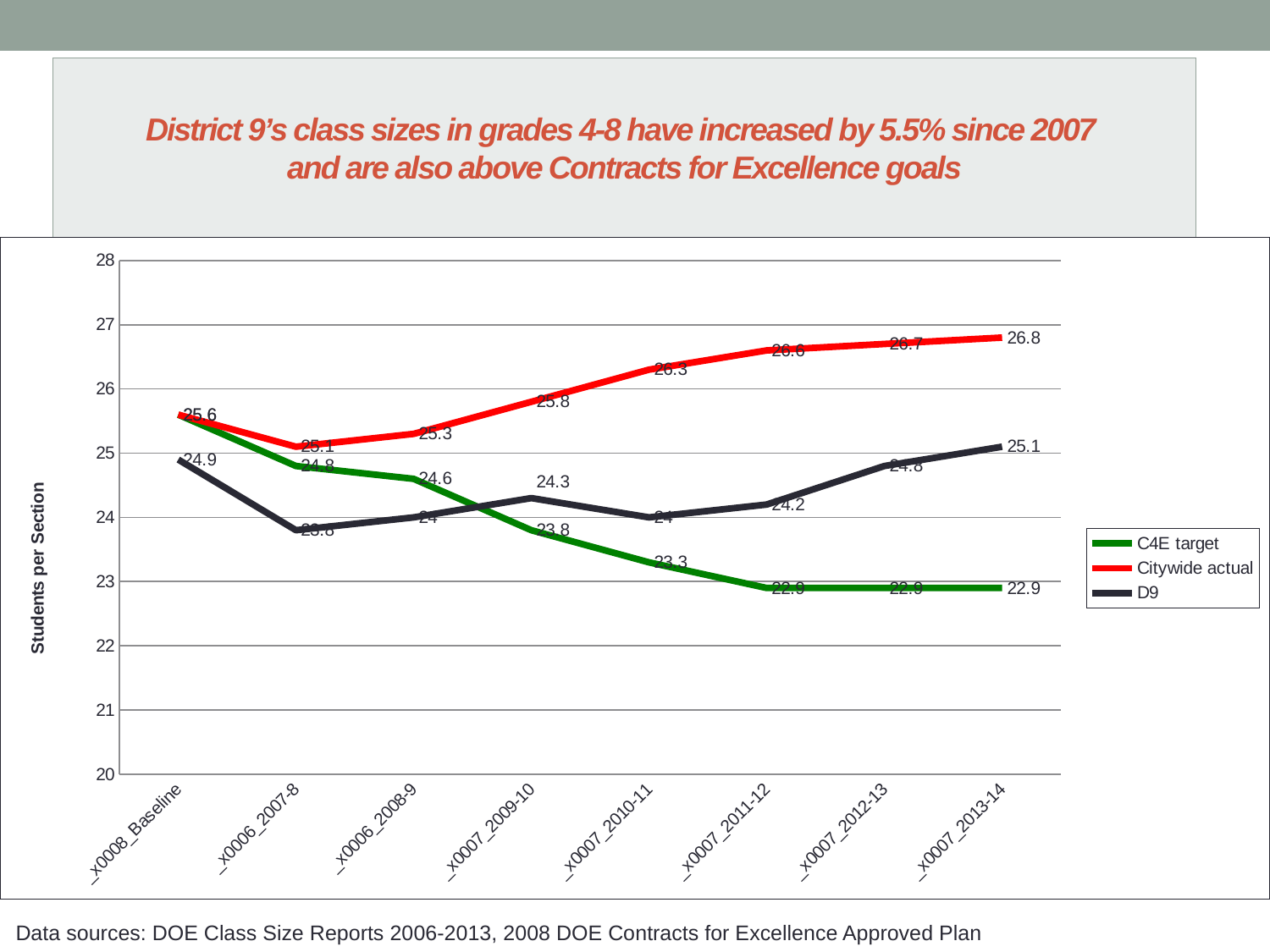
What is the D9 value for 2009-10? 24.3 What kind of chart is shown on the slide? line chart What is the Citywide actual value for 2010-11? 26.3 What is the difference between the Citywide actual and D9 values in 2013-14? 1.7 What is the D9 value at the Baseline point? 24.9 What is the D9 value for 2013-14? 25.1 Does the Citywide actual series rise or fall from 2007-8 to 2013-14? rise Which series has the highest value in 2013-14? Citywide actual How many series does the legend list? 3 What is the Citywide actual value for 2013-14? 26.8 What is the title of the vertical axis? Students per Section What is the C4E target value for 2013-14? 22.9